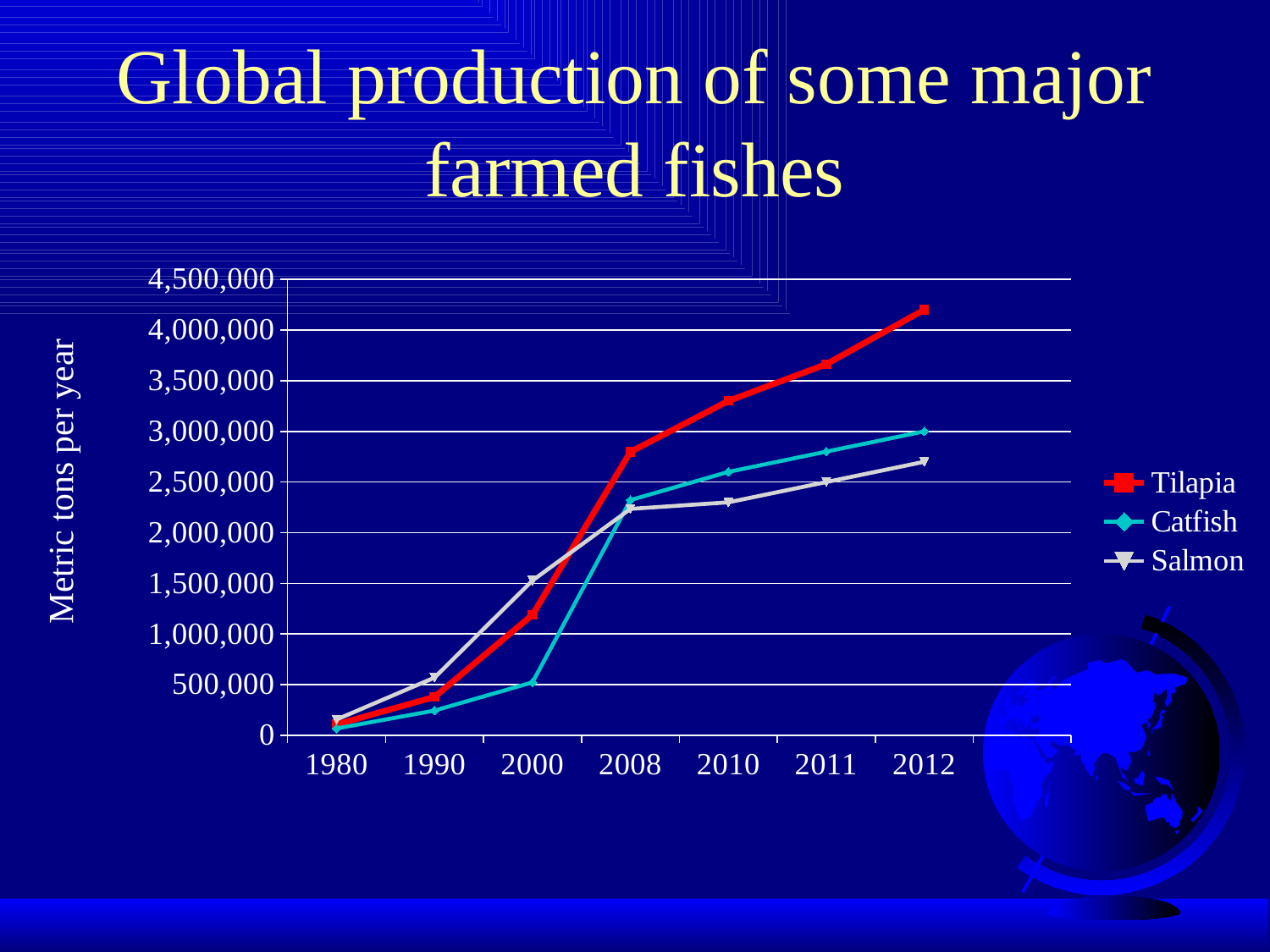
Which fish has the lowest production in 2012? Salmon Is the value for Salmon in 2012 greater or less than 3,000,000? less Is the value for Catfish in 2000 greater or less than 1,000,000? less Which fish has the highest production in 2012? Tilapia What kind of chart is shown on the slide? line chart What is the label on the vertical axis? Metric tons per year In 2000, which is larger, the production of Salmon or of Tilapia? Salmon Does the production of Tilapia rise or fall from 1980 to 2012? rise How many years are shown along the x axis? 7 How many series does the legend list? 3 Is the value for Tilapia in 2012 greater or less than 4,000,000? greater In 2000, which is larger, the production of Tilapia or of Catfish? Tilapia